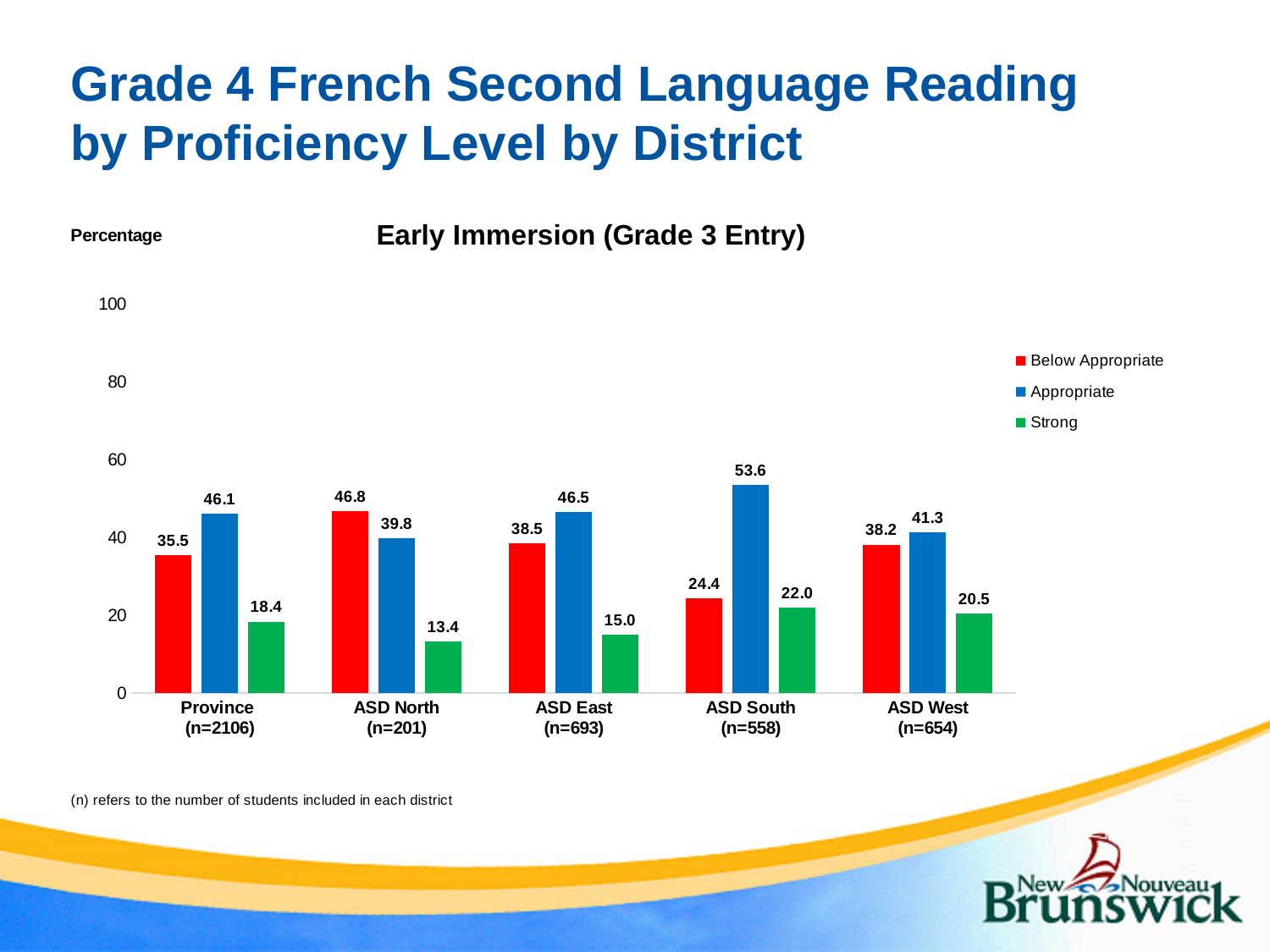
Which district has the lowest Below Appropriate percentage? ASD South Which is larger for ASD North: the Below Appropriate or the Appropriate percentage? Below Appropriate What is the Appropriate percentage for ASD South? 53.6 Is the Appropriate value for ASD West greater or less than 40? greater What is the title of the chart? Early Immersion (Grade 3 Entry) What is the Strong percentage for the Province? 18.4 How many series does the legend list? 3 How many districts (categories) are shown on the x axis? 5 What is the difference between the Appropriate and Below Appropriate percentages for ASD South? 29.2 What kind of chart is shown on the slide? Bar chart What is the Below Appropriate percentage for ASD North? 46.8 Which district has the highest Strong percentage? ASD South